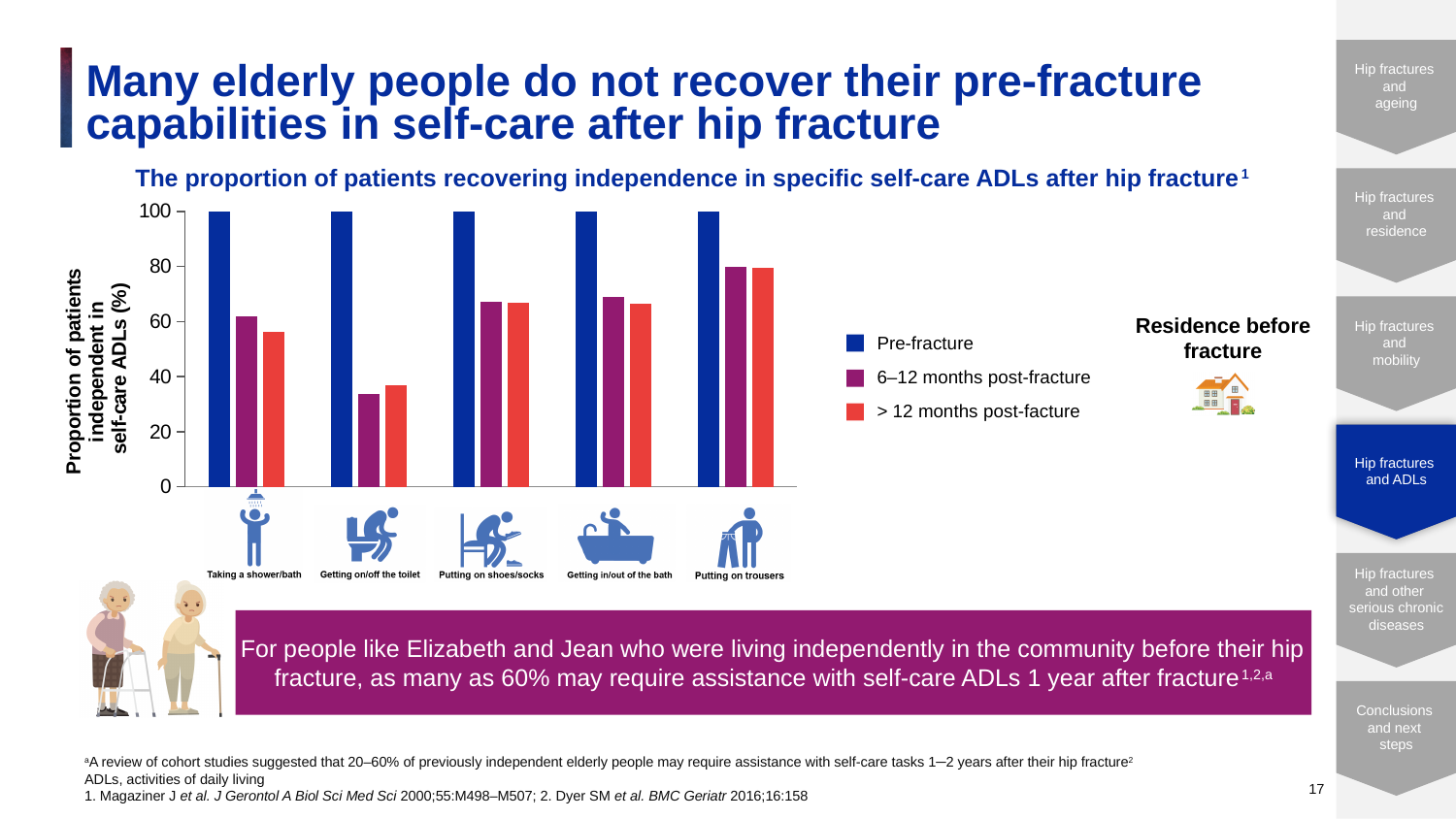
How many self-care ADL categories are shown along the x axis of the chart? 5 What kind of chart is shown on the slide? Bar chart Which category has the lowest 6–12 months post-fracture value? Getting on/off the toilet What is the label of the chart's y axis? Proportion of patients independent in self-care ADLs (%) Is the 6–12 months post-fracture value for Taking a shower/bath greater or less than 80? less Which is larger: the 6–12 months post-fracture value for Taking a shower/bath or for Getting on/off the toilet? Taking a shower/bath Is the > 12 months post-facture value for Putting on trousers greater or less than 60? greater Which category has the highest > 12 months post-facture value? Putting on trousers How many series does the chart's legend list? 3 What is the Pre-fracture value for Taking a shower/bath? 100 What is the Pre-fracture value for Putting on trousers? 100 Is the 6–12 months post-fracture value for Getting on/off the toilet greater or less than 40? less